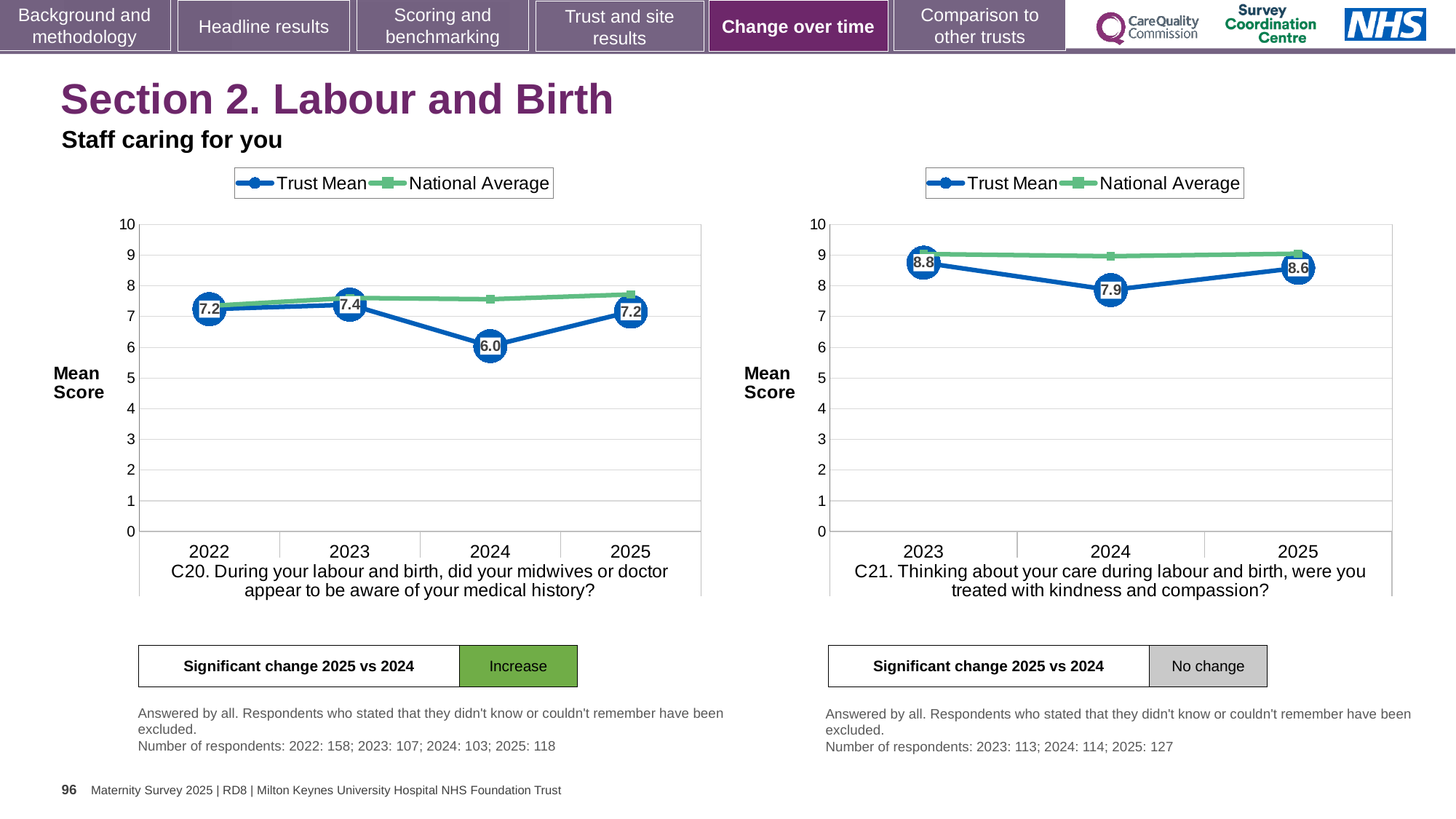
In the C20 chart (left), what is the Trust Mean for 2024? 6.0 In the C21 chart (right), what is the Trust Mean for 2023? 8.8 In the C21 chart (right), what is the Trust Mean for 2025? 8.6 In the C20 chart (left), what is the Trust Mean for 2023? 7.4 How many series does the legend of the C21 chart (right) list? 2 In the C21 chart (right), is the Trust Mean for 2024 greater or less than 8? less In the C21 chart (right), what is the difference between the Trust Mean in 2023 and in 2024? 0.9 In the C20 chart (left), which year has the lowest Trust Mean? 2024 What kind of chart is the C20 chart (left)? Line chart In the C20 chart (left), what is the difference between the Trust Mean in 2023 and in 2024? 1.4 In the C21 chart (right), which year has the highest Trust Mean? 2023 How many years are plotted on the x axis of the C20 chart (left)? 4